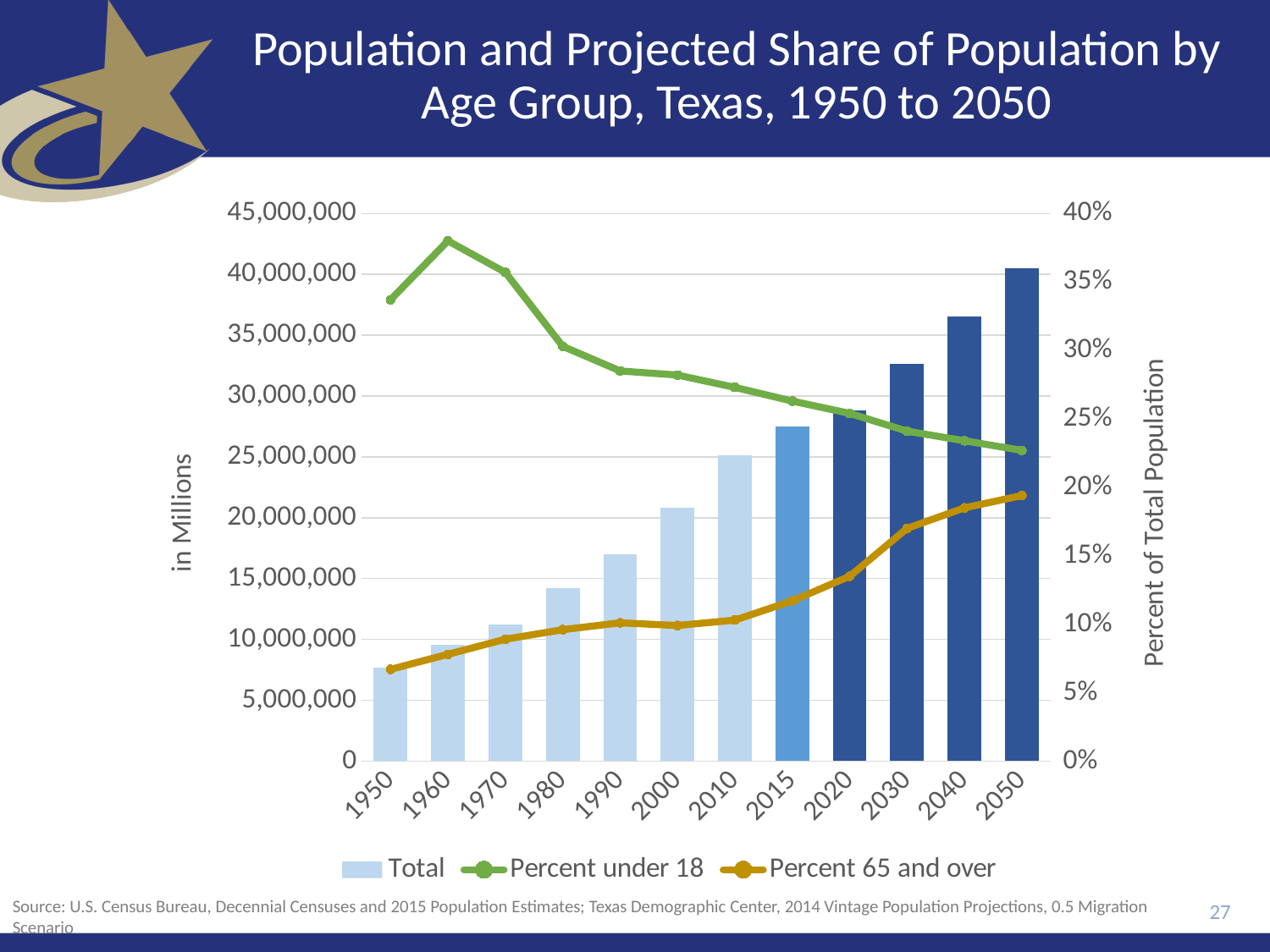
Is the Percent under 18 value for 1960 greater or less than 35%? greater Does the Percent 65 and over line rise or fall from 1950 to 2050? rise Which year has the highest Total population bar? 2050 In which year is the Percent 65 and over line at its lowest? 1950 In 2050, which is larger: Percent under 18 or Percent 65 and over? Percent under 18 How many years are shown along the x axis? 12 How many series does the legend list? 3 What kind of chart is shown on the slide? A combination bar and line chart Is the Total population for 1950 greater or less than 10,000,000? less In which year does the Percent under 18 line reach its highest point? 1960 Which year has the lowest Total population bar? 1950 Is the Total population for 2050 greater or less than 35,000,000? greater